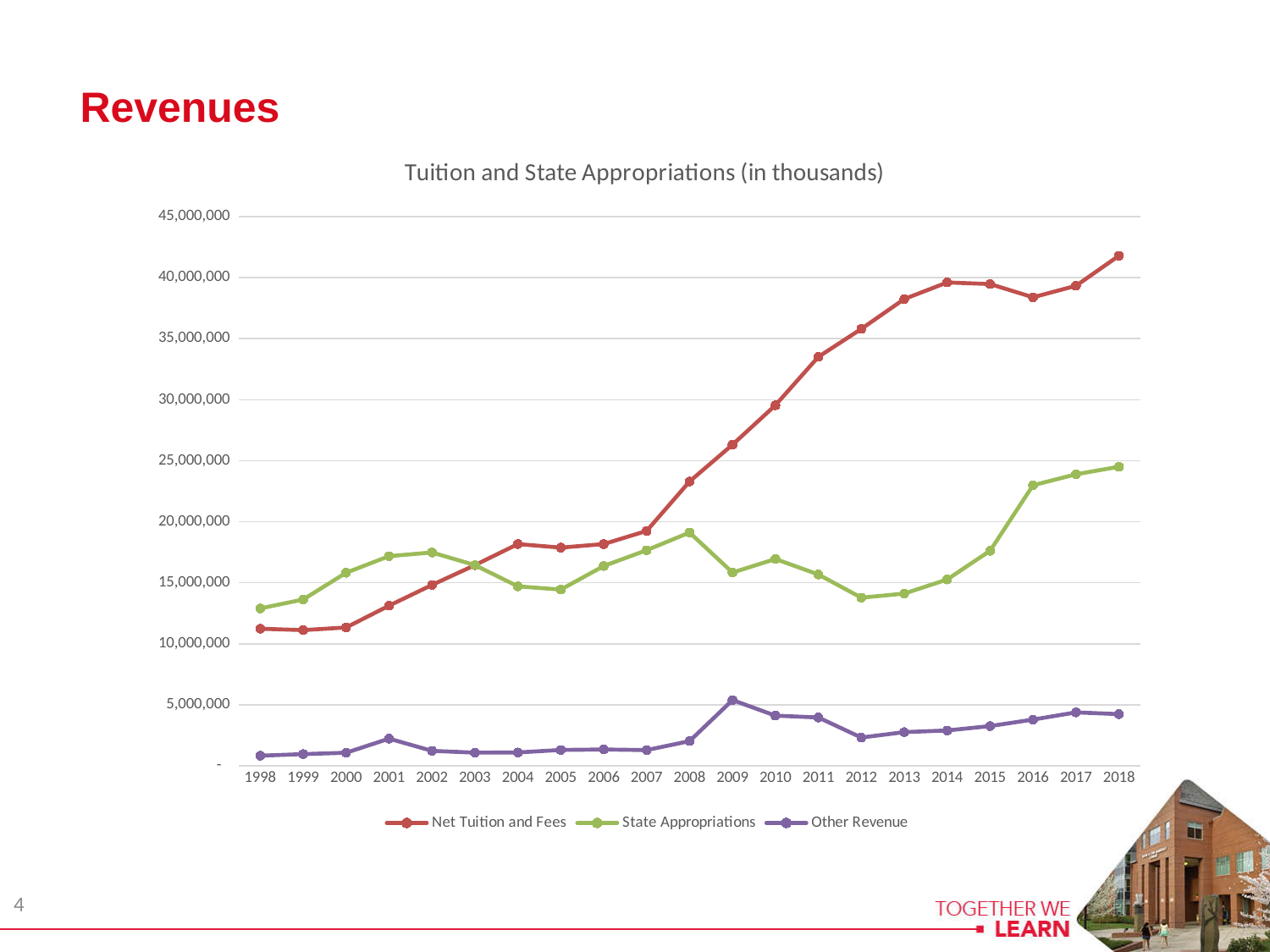
How many series does the legend list? 3 Is the value for State Appropriations in 2016 greater or less than 20,000,000? greater Does Net Tuition and Fees generally rise or fall from 1998 to 2018? rise What kind of chart is shown on the slide? line chart How many years are plotted along the x axis? 21 In 2008, which is larger: Net Tuition and Fees or State Appropriations? Net Tuition and Fees In which year is State Appropriations highest? 2018 What is the title of the chart? Tuition and State Appropriations (in thousands) Is the value for Net Tuition and Fees in 2018 greater or less than 40,000,000? greater In which year is Net Tuition and Fees highest? 2018 Which series is drawn in green? State Appropriations In which year is Other Revenue highest? 2009